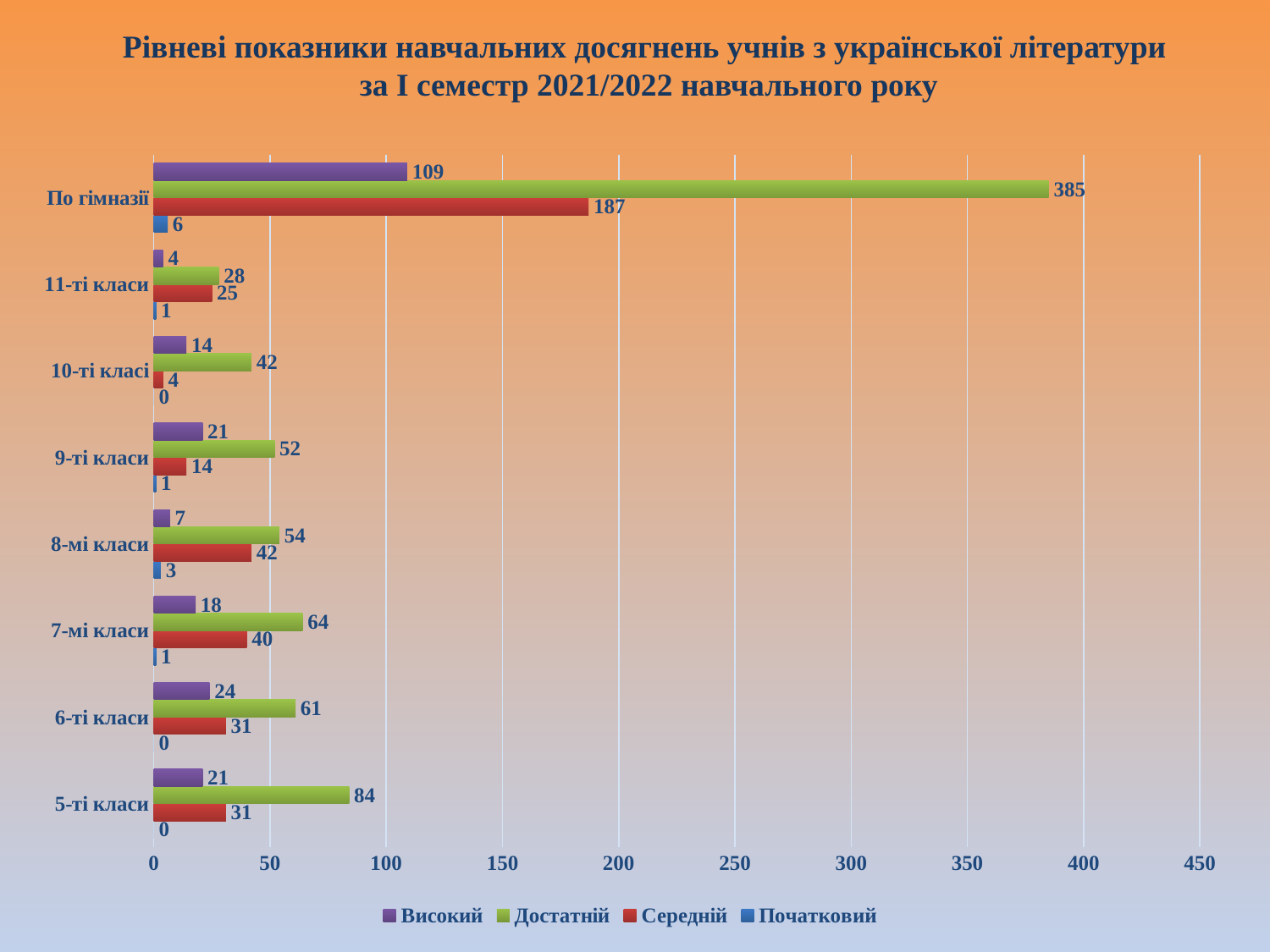
What is the value of Високий for 6-ті класи? 24 What is the total of the four values for 5-ті класи? 136 What is the difference between the Достатній and Середній values for По гімназії? 198 What is the value of Середній for 8-мі класи? 42 What is the value of Початковий for По гімназії? 6 What is the value of Достатній for По гімназії? 385 Among the class groups (excluding По гімназії), which category has the highest Достатній value? 5-ті класи Among the class groups (excluding По гімназії), which category has the lowest Високий value? 11-ті класи What kind of chart is shown on the slide? Bar chart How many series does the legend list? 4 How many categories are shown on the vertical axis? 8 Which is larger: the Середній value for 7-мі класи or the Середній value for 9-ті класи? 7-мі класи